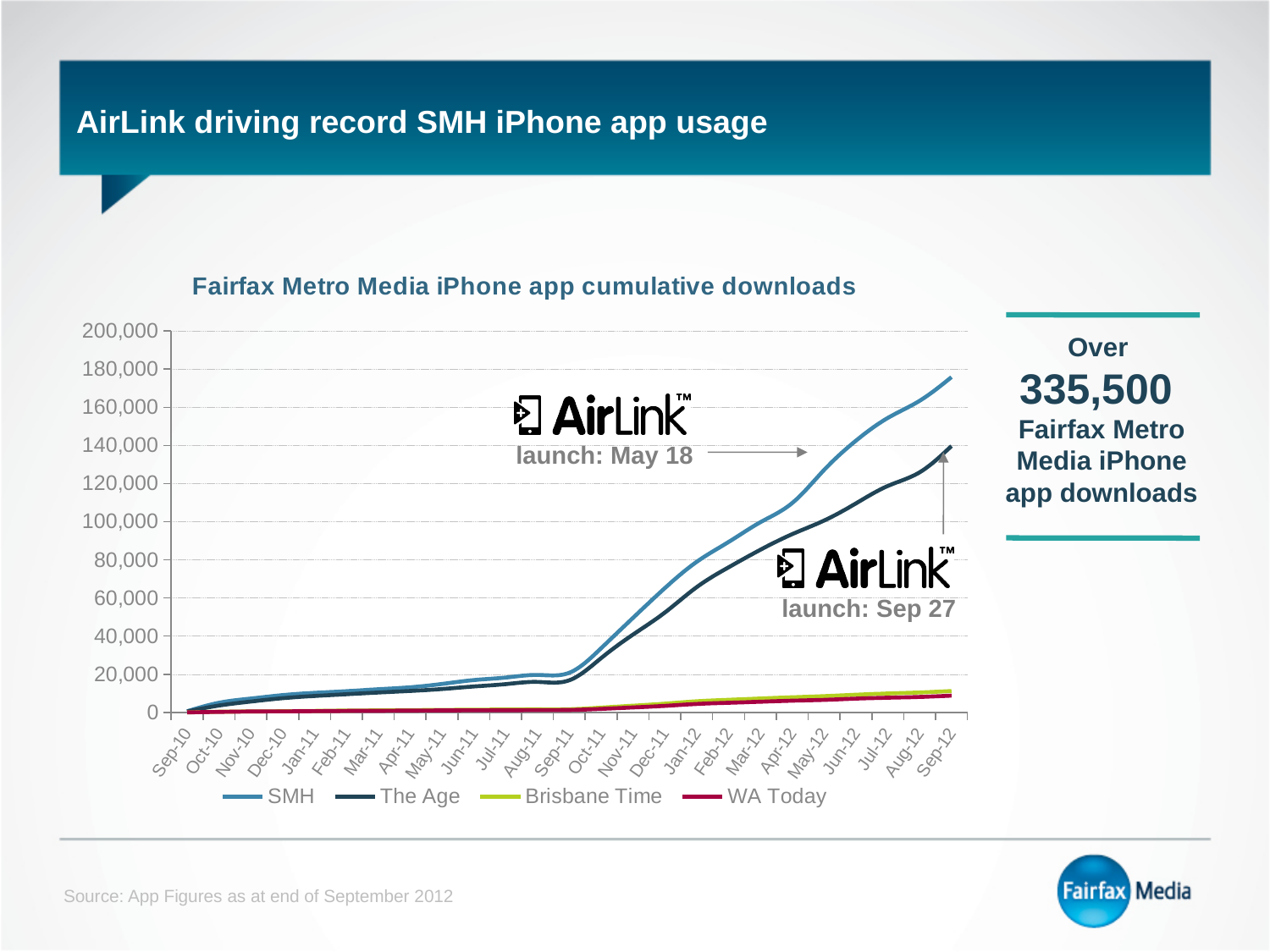
At Sep-12, which is larger: the value for SMH or the value for The Age? SMH Is the value for SMH at Sep-12 greater or less than 160,000? greater What kind of chart is shown on the slide? line chart How many monthly points are plotted along the x axis, from Sep-10 to Sep-12? 25 What is the title of the chart? Fairfax Metro Media iPhone app cumulative downloads Which series has the lowest cumulative downloads at Sep-12? WA Today According to the annotation on the chart, on what date did AirLink launch for SMH? May 18 Is the value for SMH at Sep-11 greater or less than 40,000? less Is the value for The Age at Sep-12 greater or less than 120,000? greater Do the SMH cumulative downloads rise or fall from Sep-10 to Sep-12? rise How many series does the legend list? 4 Which series has the highest cumulative downloads at Sep-12? SMH